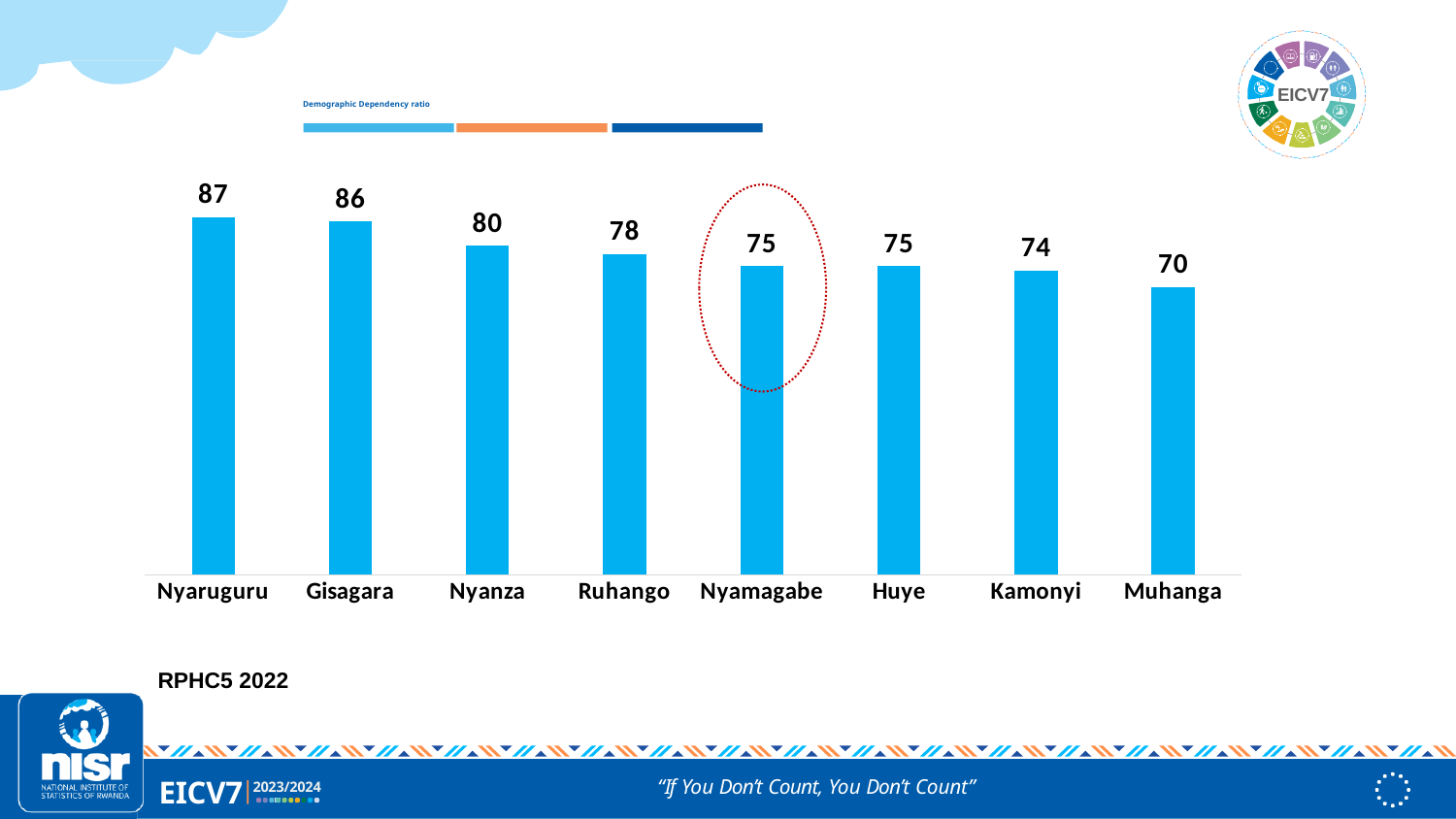
What is the difference between the values for Nyaruguru and Muhanga? 17 Which district has the highest demographic dependency ratio? Nyaruguru What is the difference between the values for Nyanza and Ruhango? 2 How many districts are shown in the chart? 8 What is the demographic dependency ratio for Nyaruguru? 87 Which district has the lowest demographic dependency ratio? Muhanga What kind of chart is shown on the slide? Bar chart What is the value shown for Nyamagabe? 75 Which is larger, the value for Gisagara or the value for Huye? Gisagara Which district's bar is highlighted with a red dotted circle? Nyamagabe Do the values rise or fall from left to right across the districts? Fall What is the value shown for Kamonyi? 74